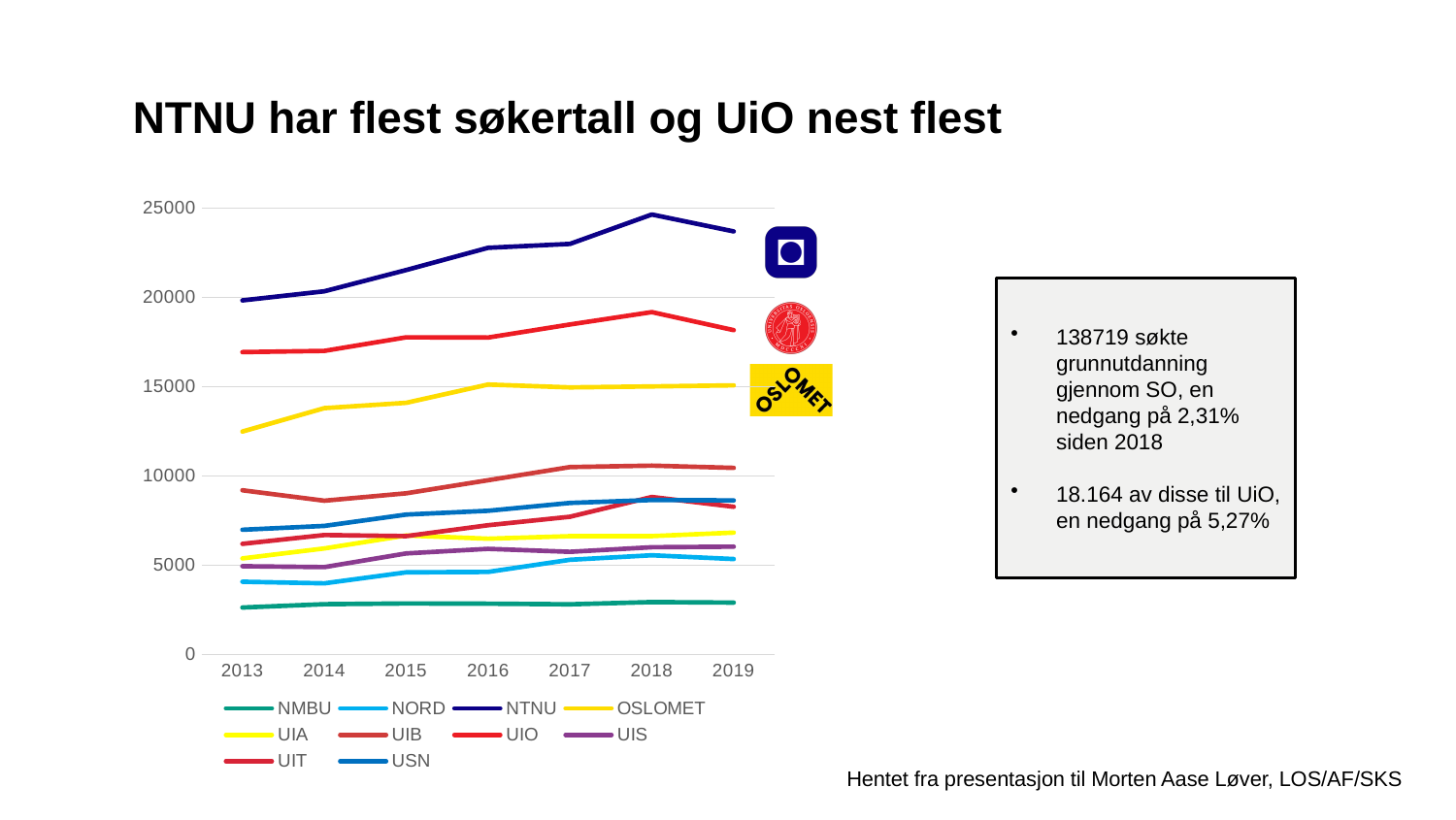
Is the value for UIO in 2013 greater or less than 20000? less What kind of chart is shown on the slide? line chart What is the title of the slide? NTNU har flest søkertall og UiO nest flest Does the NTNU line rise or fall from 2013 to 2018? rise Is the value for OSLOMET in 2013 greater or less than 10000? greater Which institution has the highest number of applicants in 2019? NTNU How many series does the legend list? 10 Which institution has the lowest number of applicants in 2019? NMBU Is the value for NMBU in 2019 greater or less than 5000? less How many years are shown on the x axis? 7 Which is larger in 2019, the value for UIB or the value for USN? UIB